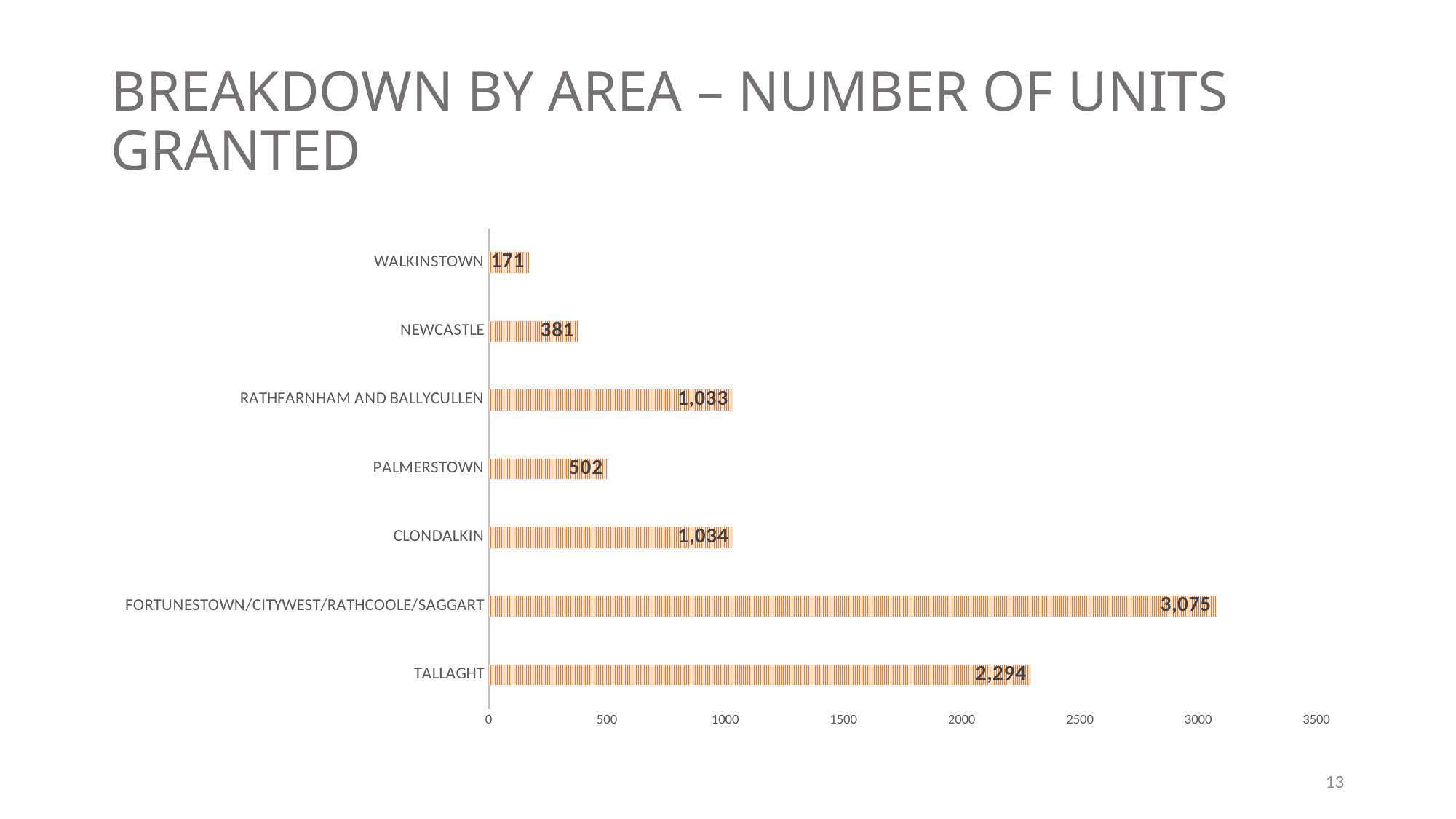
Is the value for Tallaght greater or less than 2000? greater How many areas are shown in the chart? 7 Which has more units granted, Rathfarnham and Ballycullen or Palmerstown? Rathfarnham and Ballycullen How many units were granted in Tallaght? 2,294 What type of chart is shown on the slide? Bar chart What is the difference between the units granted in Fortunestown/Citywest/Rathcoole/Saggart and Tallaght? 781 Which area has the lowest number of units granted? Walkinstown What is the number of units granted for Fortunestown/Citywest/Rathcoole/Saggart? 3,075 What is the value shown for Palmerstown? 502 How many units were granted in Newcastle? 381 Which area has the highest number of units granted? Fortunestown/Citywest/Rathcoole/Saggart What is the difference between the units granted in Palmerstown and Newcastle? 121